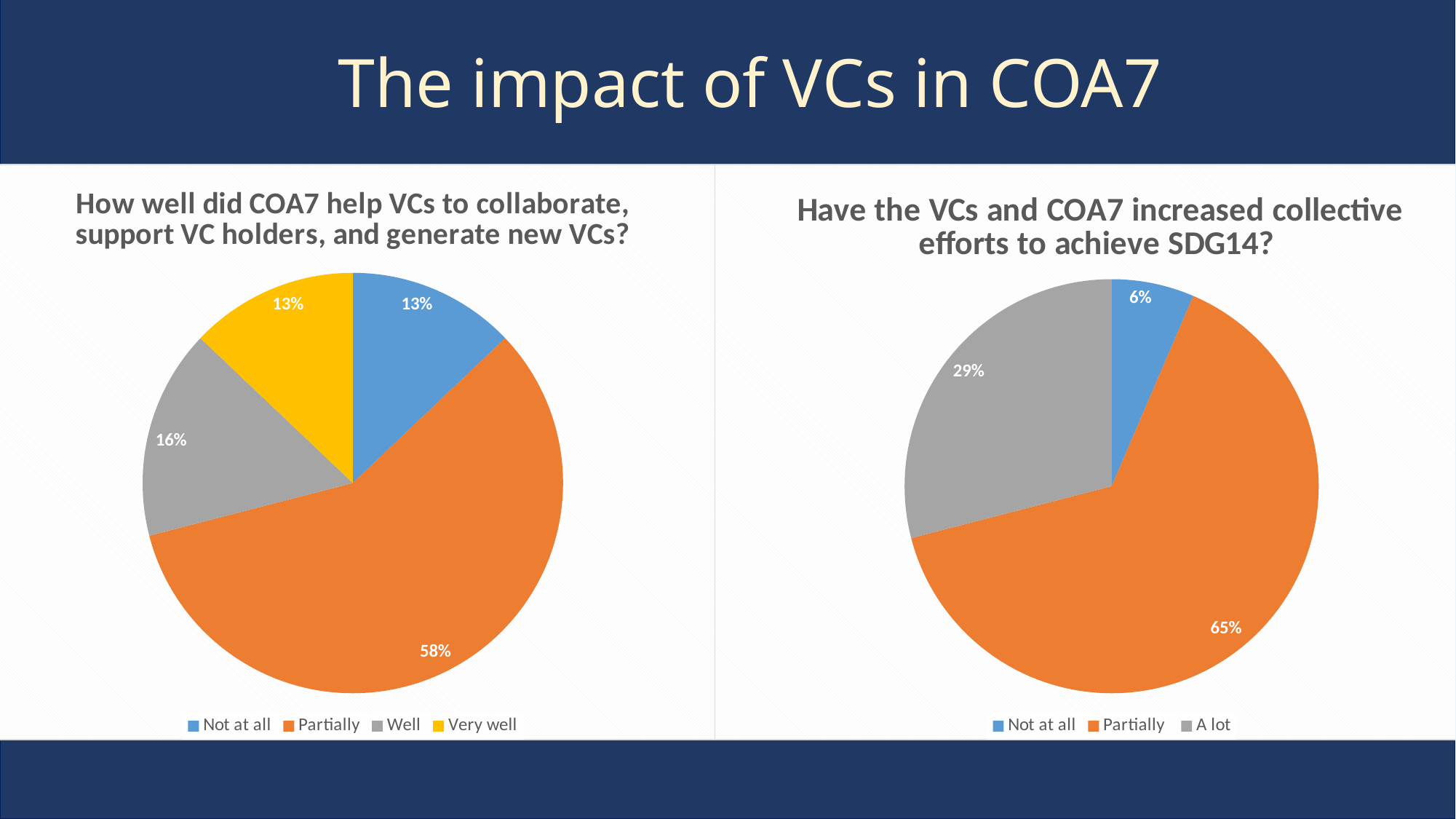
In the right chart (Have the VCs and COA7 increased collective efforts to achieve SDG14?), what is the difference between the 'Partially' and 'A lot' shares? 36% In the right chart (Have the VCs and COA7 increased collective efforts to achieve SDG14?), which category has the smallest slice? Not at all In the right chart (Have the VCs and COA7 increased collective efforts to achieve SDG14?), what share of the pie is 'Not at all'? 6% In the right chart (Have the VCs and COA7 increased collective efforts to achieve SDG14?), what share of the pie is 'A lot'? 29% In the left chart (How well did COA7 help VCs to collaborate...), what is the difference between the 'Partially' and 'Well' shares? 42% What type of chart is the right chart (Have the VCs and COA7 increased collective efforts to achieve SDG14?)? Pie chart In the left chart (How well did COA7 help VCs to collaborate...), what share of the pie is 'Well'? 16% In the left chart (How well did COA7 help VCs to collaborate...), what share of the pie is 'Partially'? 58% In the right chart (Have the VCs and COA7 increased collective efforts to achieve SDG14?), which is larger, 'Partially' or 'A lot'? Partially In the left chart (How well did COA7 help VCs to collaborate...), which colour represents 'Very well'? Yellow In the left chart (How well did COA7 help VCs to collaborate...), which category has the largest slice? Partially In the left chart (How well did COA7 help VCs to collaborate...), how many categories does the legend list? 4